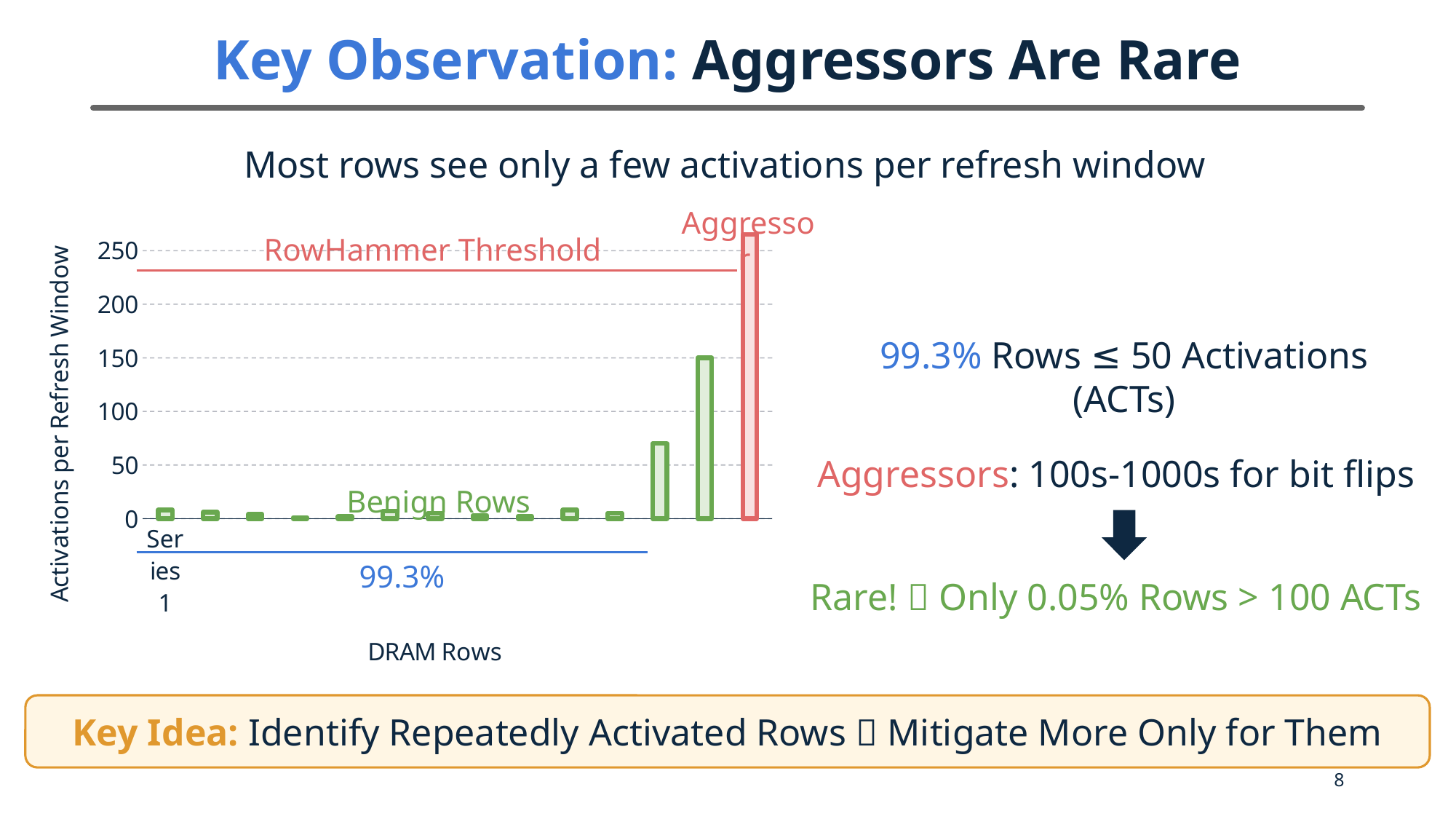
Is the value of the second-tallest green bar greater or less than 100? less What does the red horizontal line across the chart represent? RowHammer Threshold How many red bars are in the chart? 1 Which bar is the highest in the chart, the red Aggressor bar or the tallest green bar? the red Aggressor bar Is the value of the second-tallest green bar greater or less than 50? greater What kind of chart is shown on the slide? bar chart Is the value of the red Aggressor bar greater or less than 200? greater Is the red Aggressor bar above or below the RowHammer Threshold line? above What is the title of the vertical axis of the chart? Activations per Refresh Window How many bars in the chart exceed 100 activations per refresh window? 2